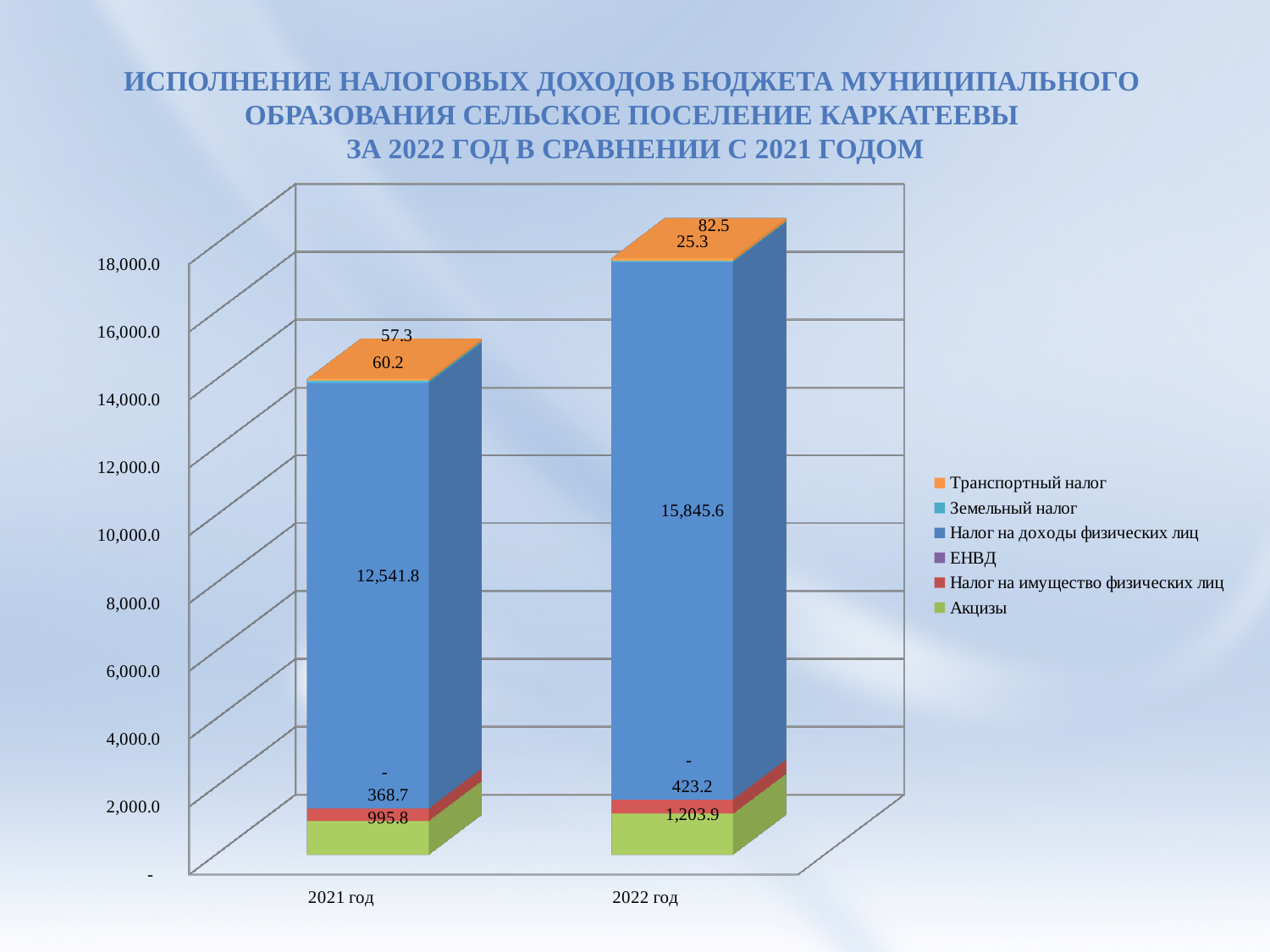
By how much did Налог на доходы физических лиц increase from 2021 год to 2022 год? 3,303.8 What type of chart is shown on the slide? Stacked bar chart Which series is shown in orange in the legend? Транспортный налог What is the value of Транспортный налог for 2021 год? 57.3 What is the value of Акцизы for 2022 год? 1,203.9 Which year has the larger value for Налог на имущество физических лиц, 2021 год or 2022 год? 2022 год What is the difference between Акцизы in 2022 год and 2021 год? 208.1 How many categories (years) are shown on the x axis? 2 What is the value of Земельный налог for 2022 год? 25.3 What is the value of Налог на доходы физических лиц for 2021 год? 12,541.8 How many series does the legend list? 6 What is the value of Налог на доходы физических лиц for 2022 год? 15,845.6